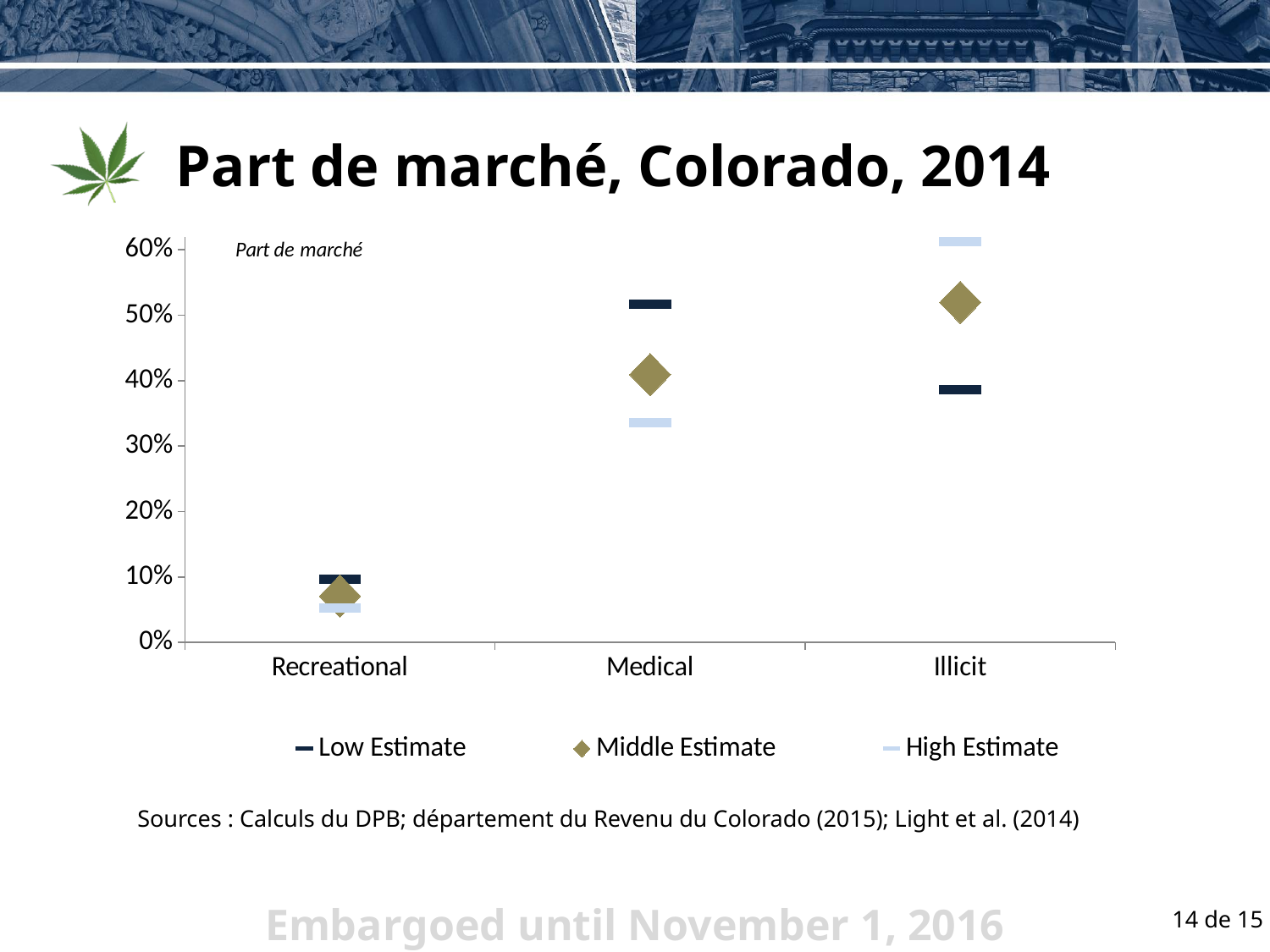
Is the Low Estimate for Medical greater or less than 50%? greater Is the High Estimate for Illicit greater or less than 50%? greater Which category has the highest Low Estimate? Medical How many series does the chart's legend list? 3 Which category has the lowest Middle Estimate? Recreational Is the Low Estimate for Illicit greater or less than 40%? less Which category has the highest Middle Estimate? Illicit How many categories are shown on the x axis of the chart? 3 What is the title of the slide's chart? Part de marché What are the three series named in the chart's legend? Low Estimate, Middle Estimate, High Estimate Which is larger, the Low Estimate for Medical or the Low Estimate for Illicit? Medical